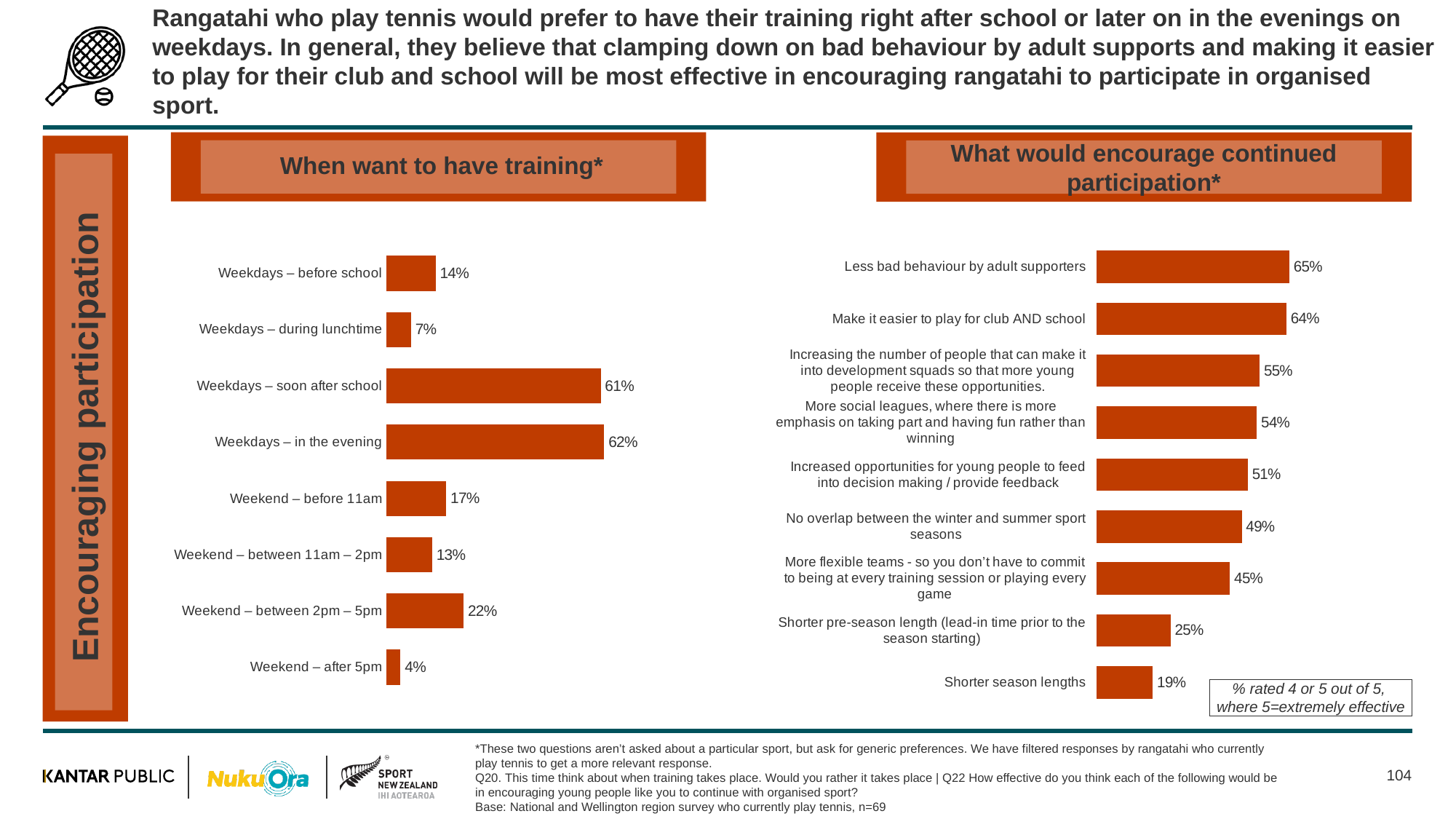
In the 'When want to have training*' chart, what is the value for 'Weekdays – soon after school'? 61% How many categories are shown in the 'What would encourage continued participation*' chart? 9 How many categories are shown in the 'When want to have training*' chart? 8 In the 'When want to have training*' chart, which is larger: 'Weekdays – before school' or 'Weekend – between 11am – 2pm'? Weekdays – before school In the 'What would encourage continued participation*' chart, what is the difference between 'Less bad behaviour by adult supporters' and 'Shorter season lengths'? 46% What kind of chart is the 'When want to have training*' chart? Bar chart In the 'What would encourage continued participation*' chart, what is the value for 'Shorter pre-season length (lead-in time prior to the season starting)'? 25% In the 'When want to have training*' chart, what is the difference between 'Weekend – between 2pm – 5pm' and 'Weekend – before 11am'? 5% In the 'When want to have training*' chart, which category has the lowest value? Weekend – after 5pm In the 'What would encourage continued participation*' chart, which category has the highest value? Less bad behaviour by adult supporters In the 'What would encourage continued participation*' chart, what is the value for 'No overlap between the winter and summer sport seasons'? 49% What is the title of the chart on the left side of the slide? When want to have training*